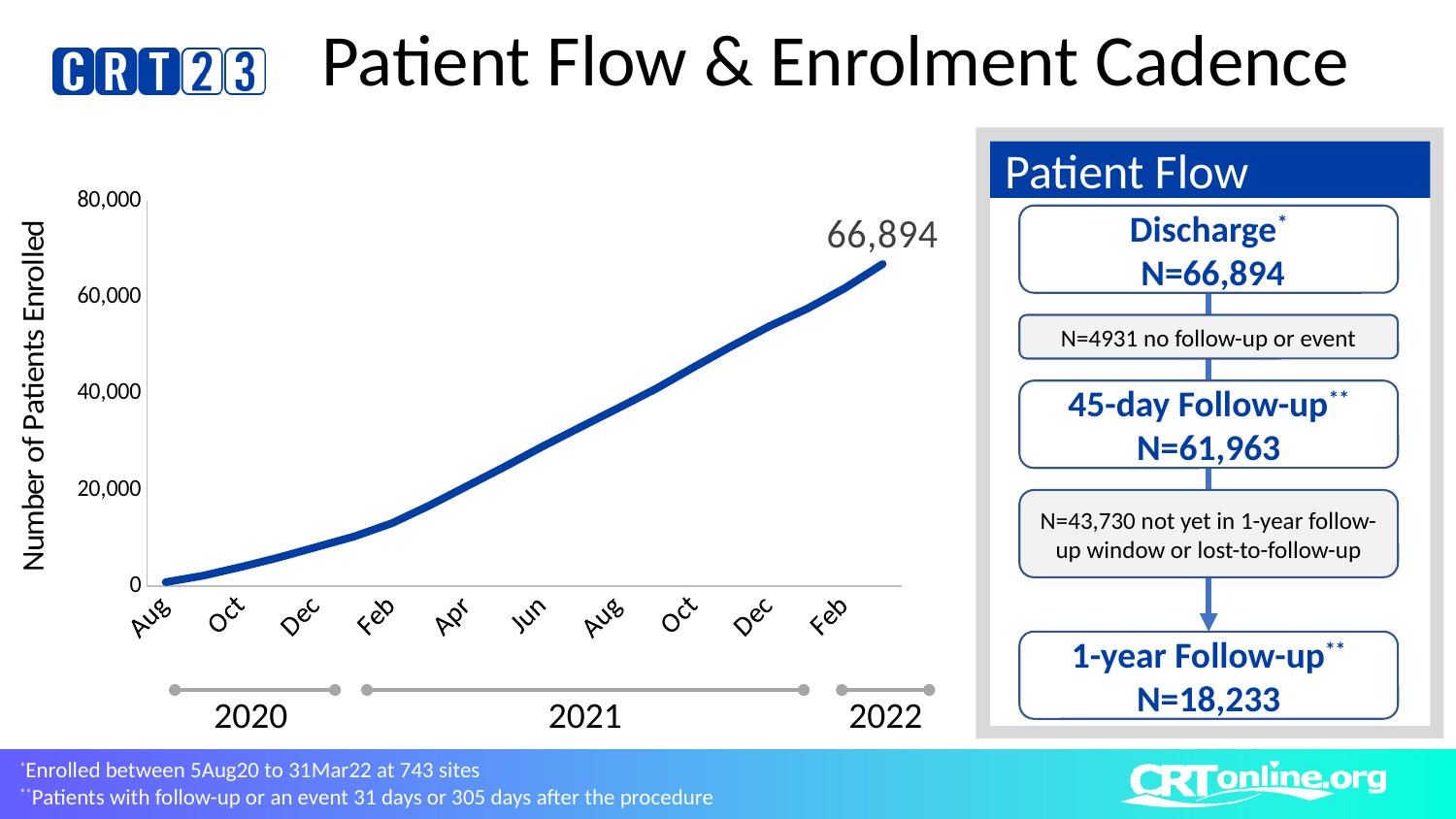
At which month label is the enrolment line at its lowest value? Aug (2020) What is the highest tick value shown on the vertical axis? 80,000 Is the number of patients enrolled at Feb 2021 greater or less than 20,000? less What is the final value labelled at the end of the enrolment line? 66,894 Is the number of patients enrolled at Oct 2020 greater or less than 20,000? less Is the number of patients enrolled at Dec 2021 greater or less than 40,000? greater What type of chart is shown on the left of the slide? line chart What is the label on the vertical axis of the chart? Number of Patients Enrolled Does the number of patients enrolled rise or fall from Aug 2020 to Feb 2022? rise How many month labels are shown along the x axis of the chart? 10